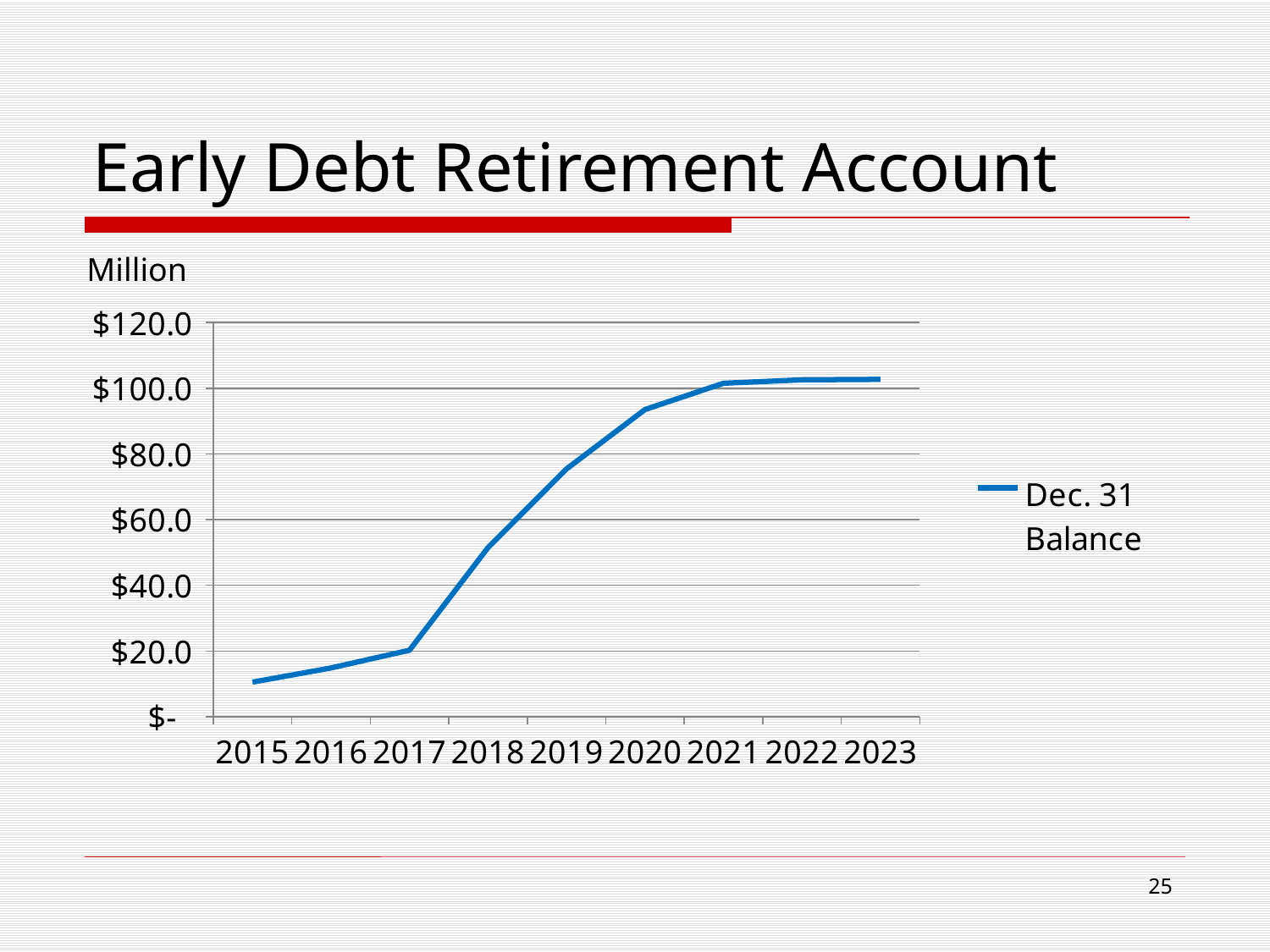
Which year has the lowest Dec. 31 Balance? 2015 How many series does the legend list? 1 What kind of chart is shown on the slide? Line chart Is the Dec. 31 Balance for 2018 greater or less than $40.0 million? greater What unit label appears above the y axis? Million What is the name of the series shown in the legend? Dec. 31 Balance Is the Dec. 31 Balance for 2020 greater or less than $80.0 million? greater Which year has the larger Dec. 31 Balance, 2017 or 2019? 2019 Does the Dec. 31 Balance generally rise or fall from 2015 to 2023? Rise How many years are plotted along the x axis? 9 Is the Dec. 31 Balance for 2015 greater or less than $20.0 million? less